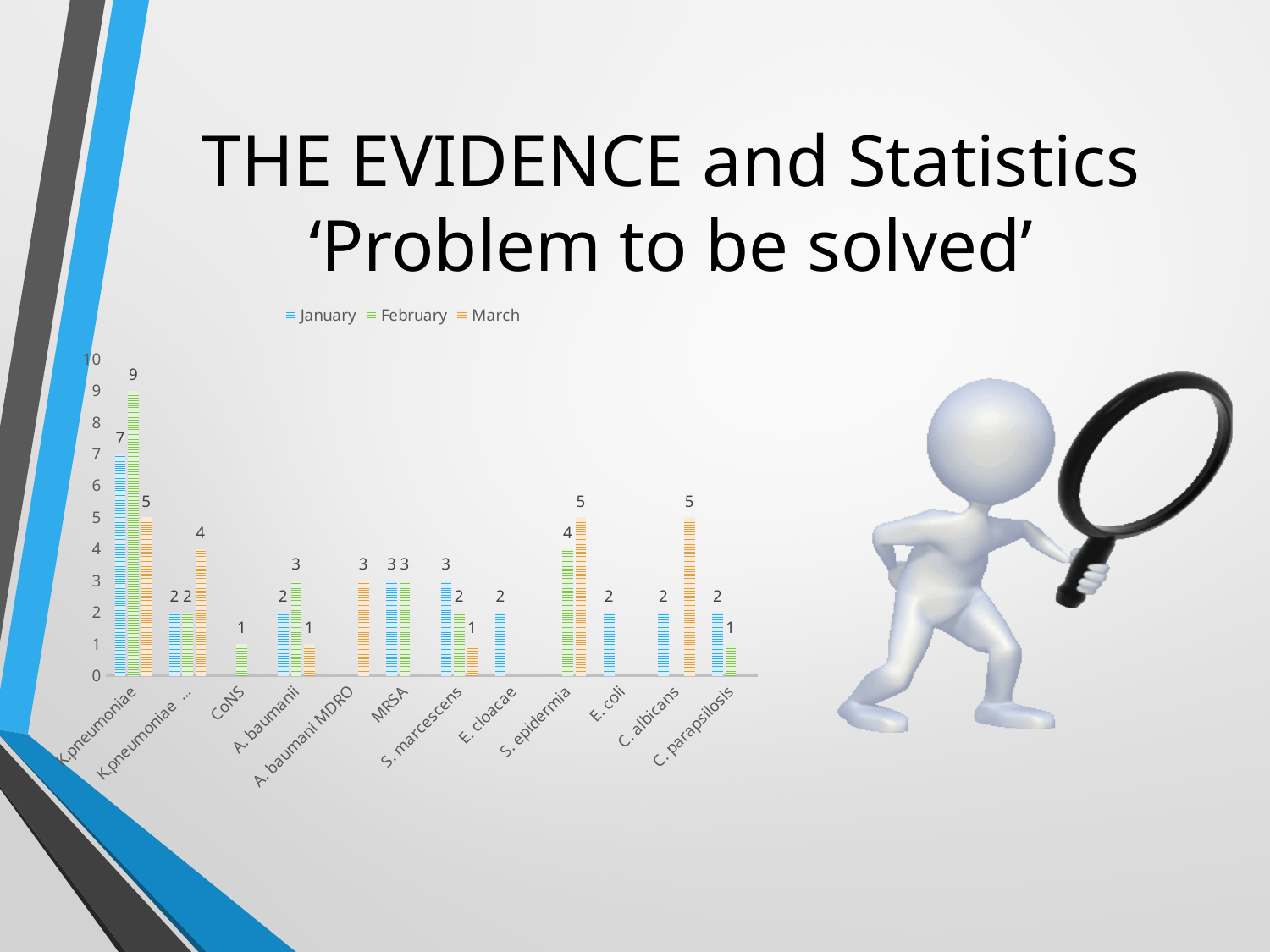
Which category has the highest February value? K.pneumoniae What is the March value for A. baumani MDRO? 3 Which series is shown in orange in the legend? March What kind of chart is shown on the slide? Bar chart Which is larger for S. marcescens, the January value or the March value? January What is the February value for S. epidermia? 4 What is the January value for K.pneumoniae? 7 What is the difference between the February and March values for K.pneumoniae? 4 What is the March value for C. albicans? 5 What is the February value for K.pneumoniae? 9 How many series does the legend list? 3 How many categories are shown on the x axis? 12